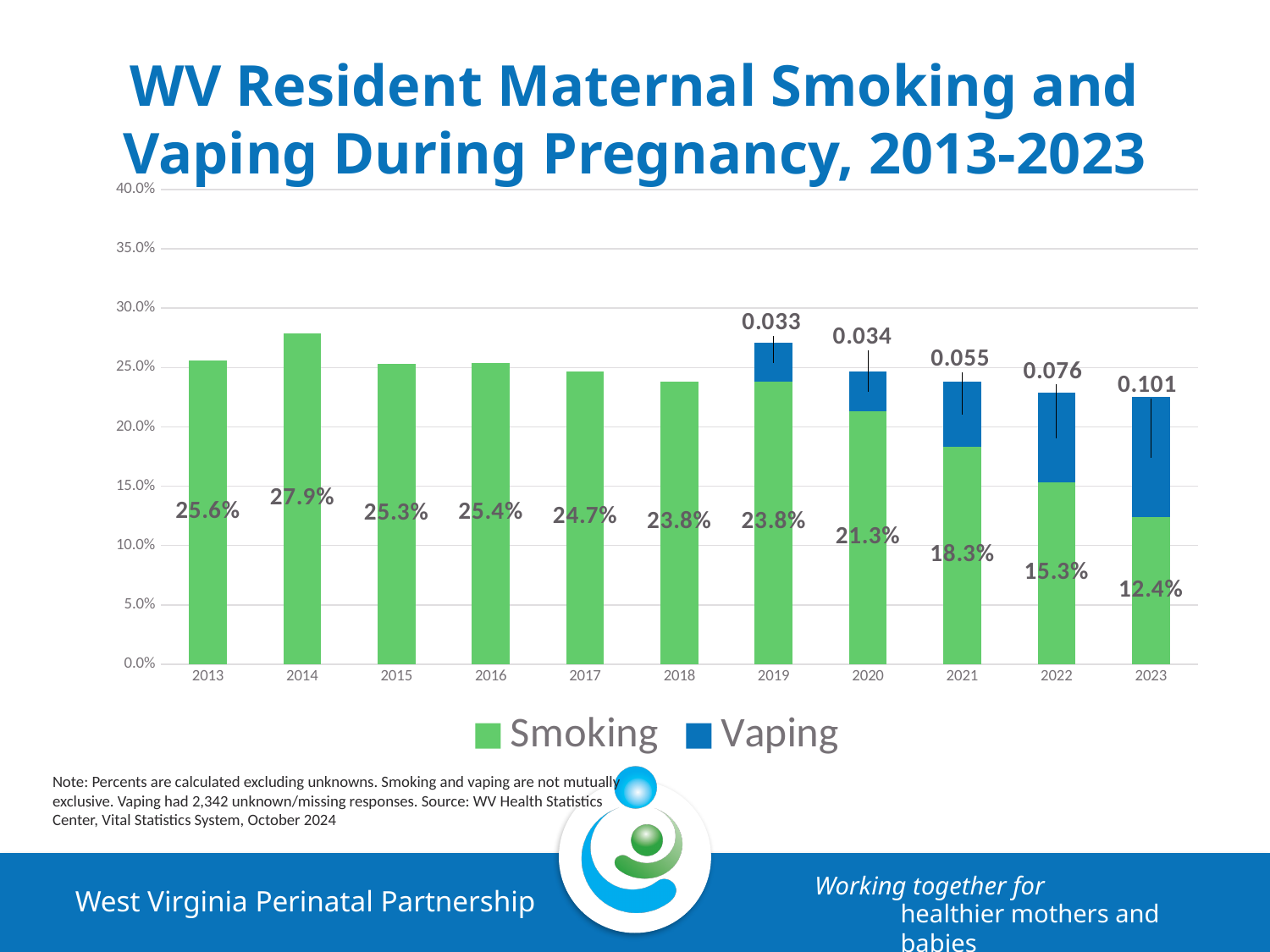
How many years are shown on the x axis? 11 Which is larger, the Smoking value for 2020 or for 2021? 2020 Which year has the highest Smoking value? 2014 How many series does the legend list? 2 What is the Smoking value for 2023? 12.4% What is the Smoking value for 2014? 27.9% What is the Vaping data label for 2023? 0.101 Which year has the lowest Smoking value? 2023 What is the Vaping data label for 2021? 0.055 What kind of chart is shown on the slide? Stacked bar chart What is the difference between the Smoking values for 2014 and 2023? 15.5% Does the Smoking value rise or fall from 2018 to 2023? Fall